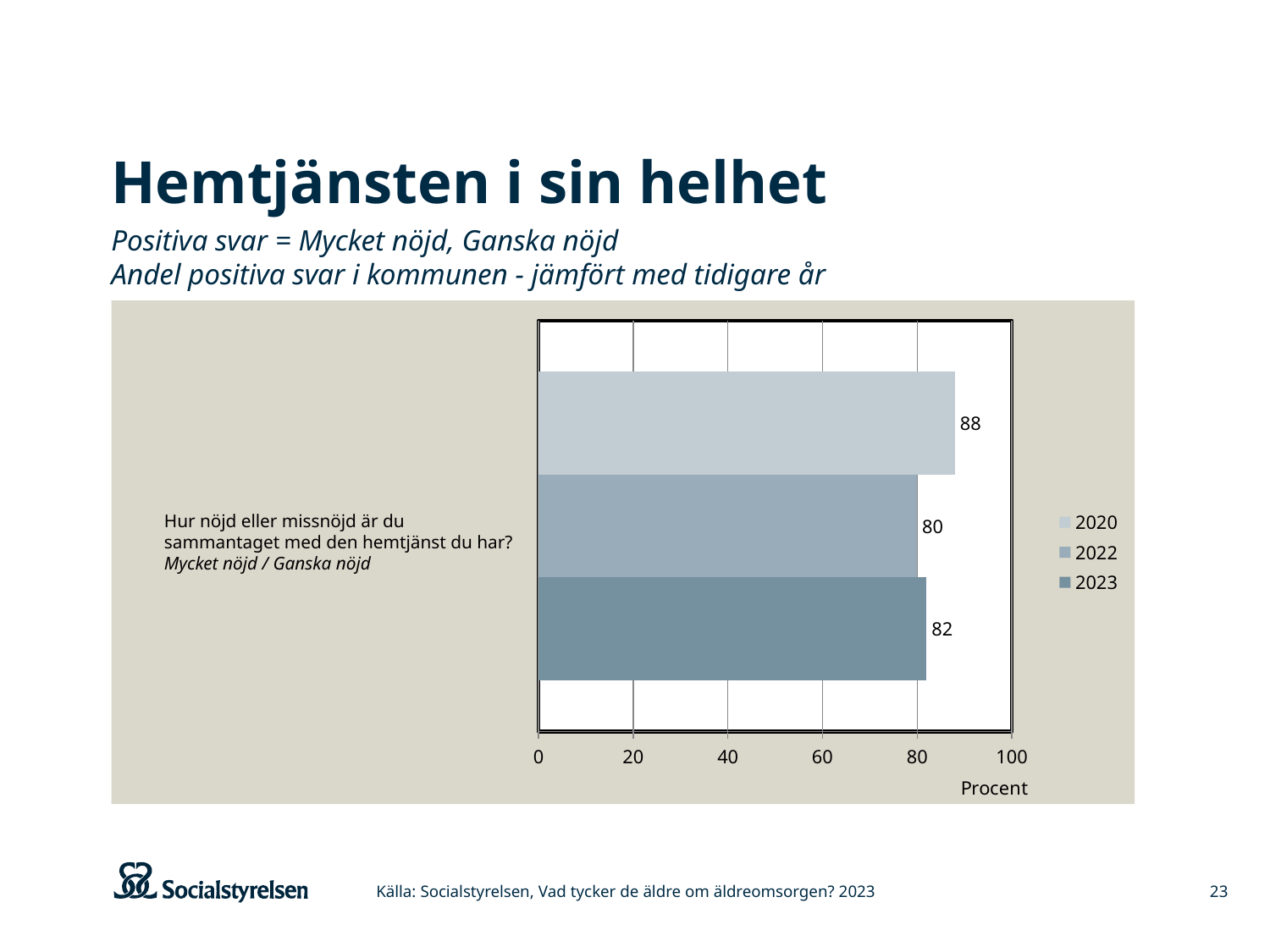
What is the value for 2023 in the chart? 82 How many series does the legend list? 3 Which year has the lowest value in the chart? 2022 What kind of chart is shown on the slide? bar chart Is the value for 2022 greater or less than 60? greater What is the label of the horizontal axis? Procent What is the difference between the values for 2023 and 2022? 2 What is the difference between the values for 2020 and 2022? 8 Which year has the highest value in the chart? 2020 What is the value for 2020 in the chart? 88 What is the value for 2022 in the chart? 80 Which is larger, the value for 2020 or the value for 2023? 2020